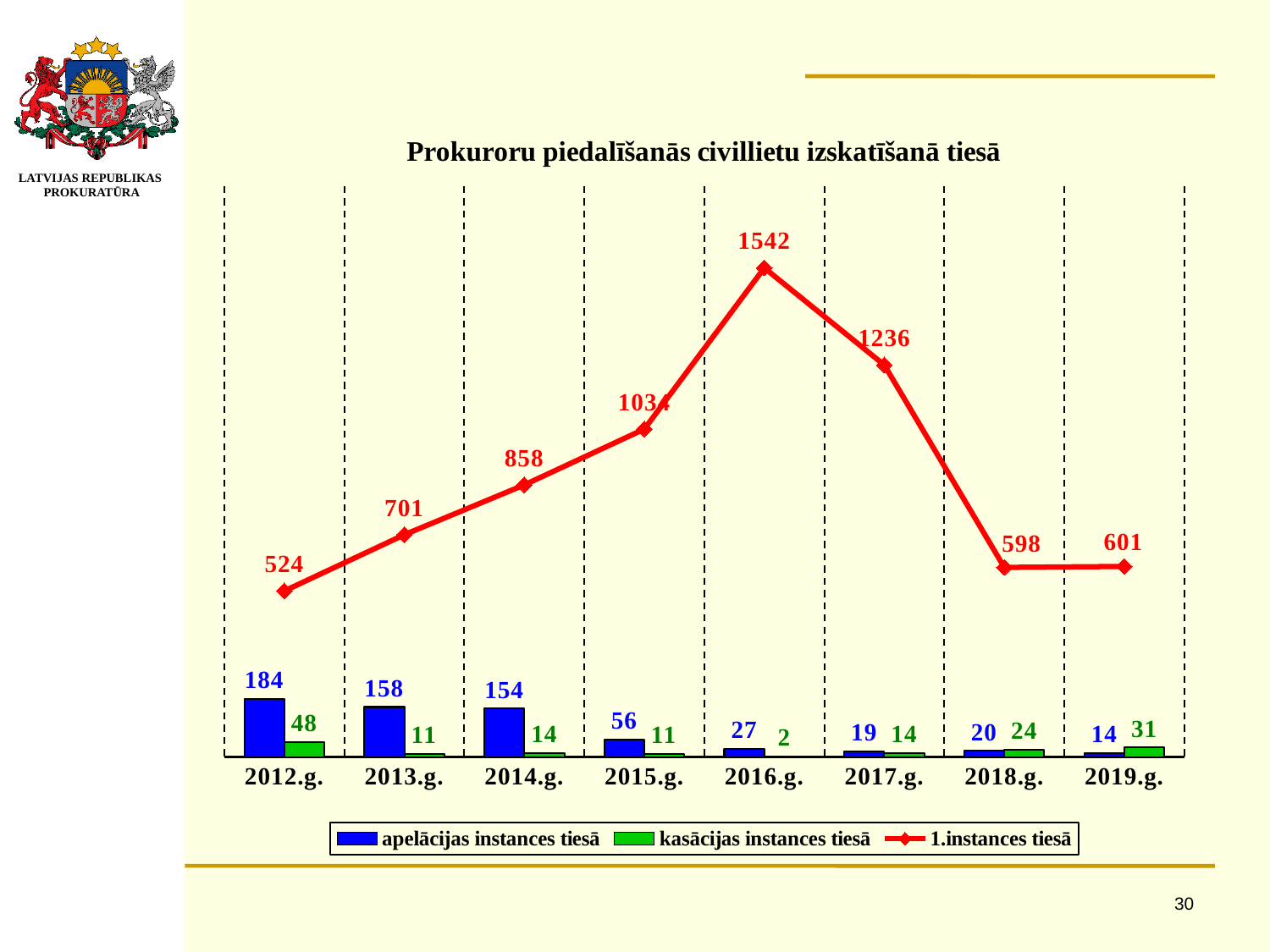
Which is larger in 2018.g.: apelācijas instances tiesā or kasācijas instances tiesā? kasācijas instances tiesā What is the value for 1.instances tiesā in 2016.g.? 1542 What is the value for apelācijas instances tiesā in 2012.g.? 184 What is the difference between the 1.instances tiesā values for 2016.g. and 2017.g.? 306 In which year is the value for 1.instances tiesā highest? 2016.g. What is the value for kasācijas instances tiesā in 2019.g.? 31 How many years are shown on the x axis? 8 Does the value for apelācijas instances tiesā rise or fall from 2012.g. to 2016.g.? Fall What kinds of chart are combined on this slide? Bar chart and line chart How many series does the legend list? 3 In which year is the value for kasācijas instances tiesā lowest? 2016.g. What colour are the bars for kasācijas instances tiesā? Green